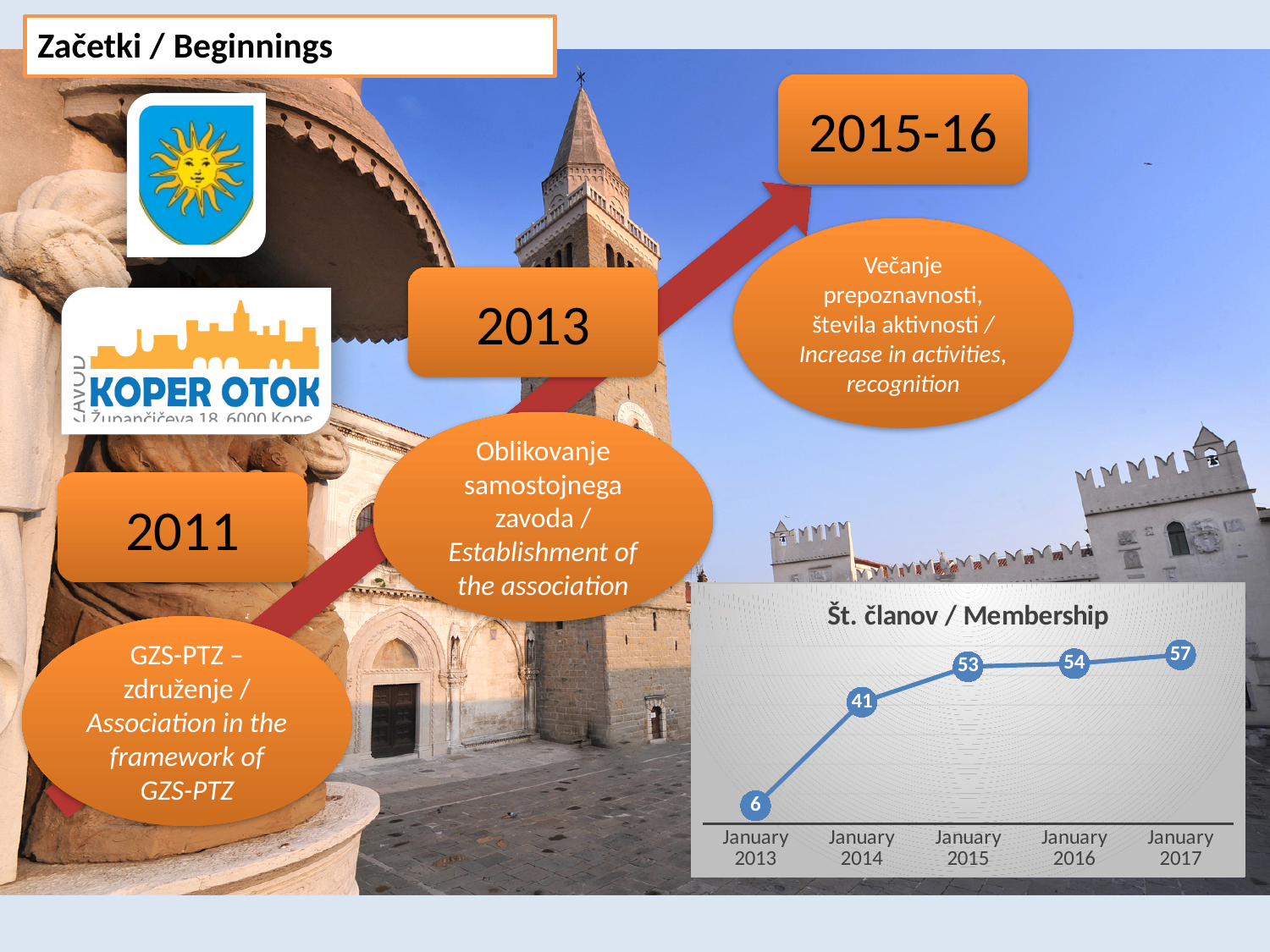
What is the title of the chart on the slide? Št. članov / Membership What is the difference in membership between January 2014 and January 2013? 35 What is the difference in membership between January 2017 and January 2016? 3 Which point has the highest membership value? January 2017 How many data points are plotted in the membership chart? 5 What is the membership value for January 2015? 53 What is the membership value for January 2014? 41 What kind of chart is used to show membership? line chart What is the membership value for January 2013? 6 Which is larger, the membership in January 2015 or January 2014? January 2015 Which point has the lowest membership value? January 2013 What is the membership value for January 2017? 57